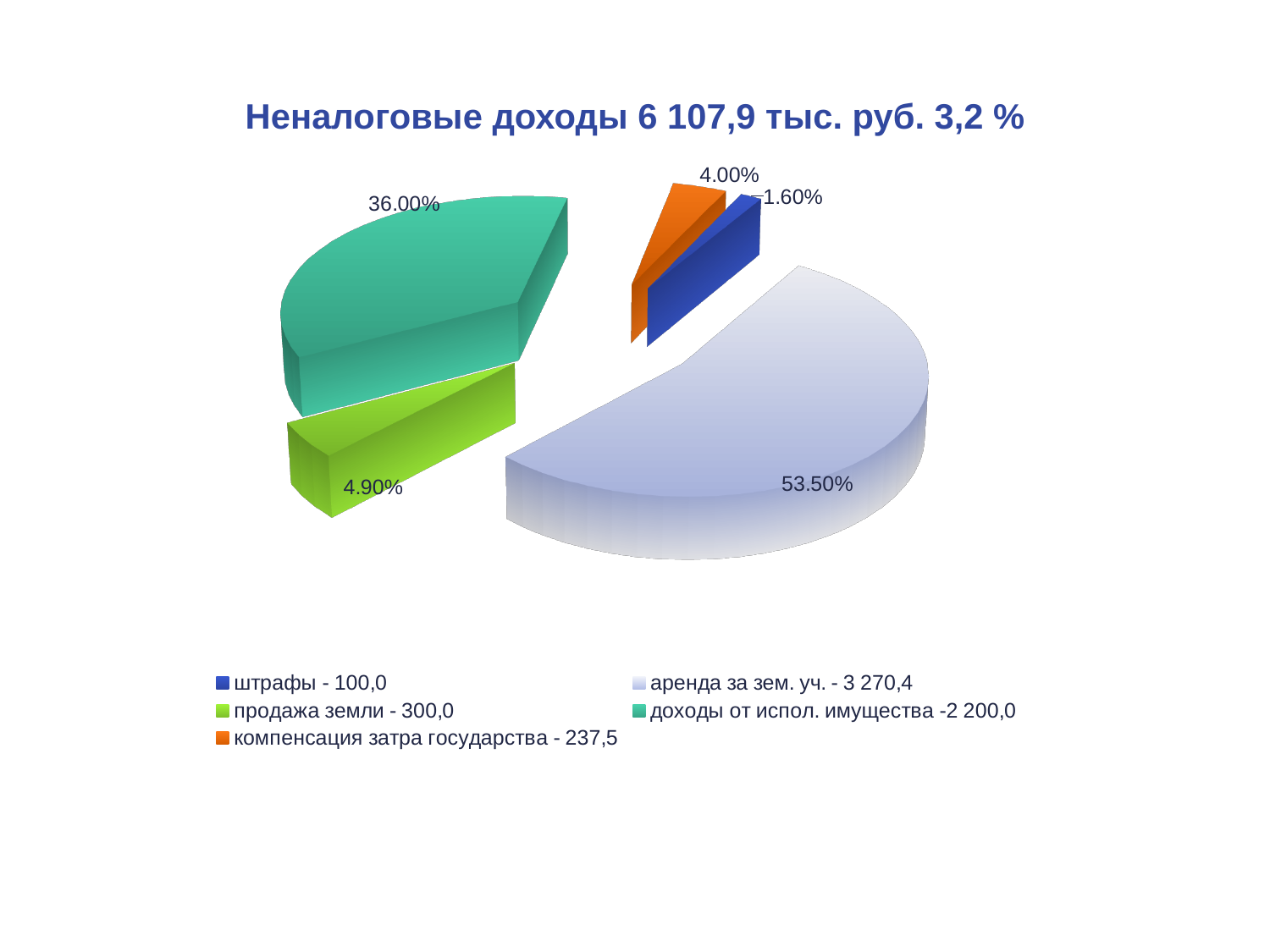
Which category has the largest slice of the pie? аренда за зем. уч. - 3 270,4 How many slices does the pie chart have? 5 Which slice is larger: 'продажа земли - 300,0' or 'компенсация затра государства - 237,5'? продажа земли - 300,0 What kind of chart is shown on the slide? pie chart What is the difference in percentage points between the 'аренда за зем. уч. - 3 270,4' slice and the 'доходы от испол. имущества -2 200,0' slice? 17.50% What is the title of the chart? Неналоговые доходы 6 107,9 тыс. руб. 3,2 % What share of the pie does the slice for 'аренда за зем. уч. - 3 270,4' represent? 53.50% What share of the pie does the slice for 'доходы от испол. имущества -2 200,0' represent? 36.00% What share of the pie does the slice for 'штрафы - 100,0' represent? 1.60% Which category has the smallest slice of the pie? штрафы - 100,0